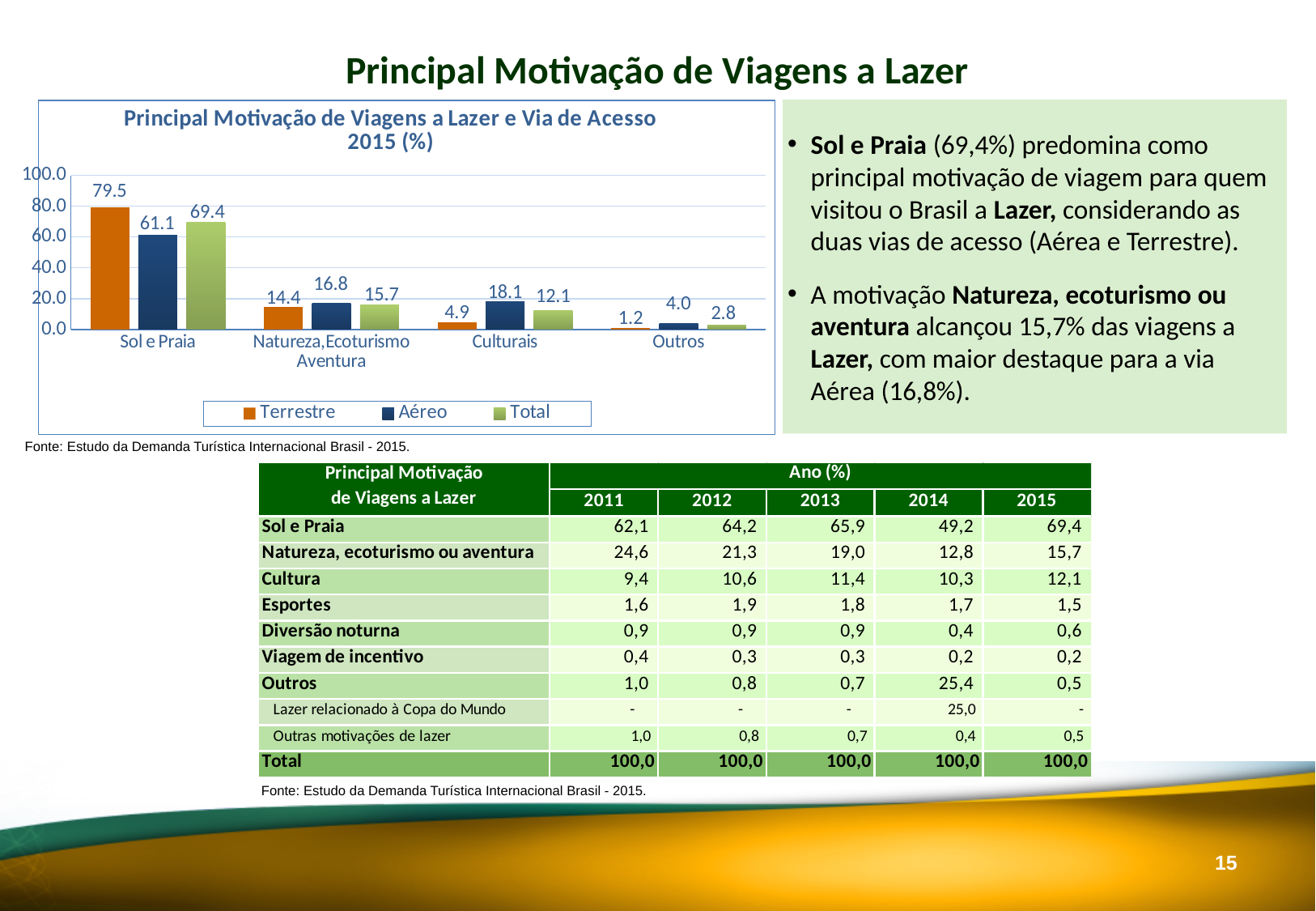
Which category has the highest Total value? Sol e Praia What is the Aéreo value for Culturais? 18.1 What is the Total value for Natureza,Ecoturismo Aventura? 15.7 What is the difference between the Terrestre and Aéreo values for Sol e Praia? 18.4 How many categories are shown on the x axis? 4 What is the title of the chart? Principal Motivação de Viagens a Lazer e Via de Acesso 2015 (%) How many series does the legend list? 3 For Culturais, which is larger: the Terrestre value or the Aéreo value? Aéreo Which category has the lowest Terrestre value? Outros What is the Aéreo value for Outros? 4.0 What type of chart is shown on the slide? bar chart What is the Terrestre value for Sol e Praia? 79.5